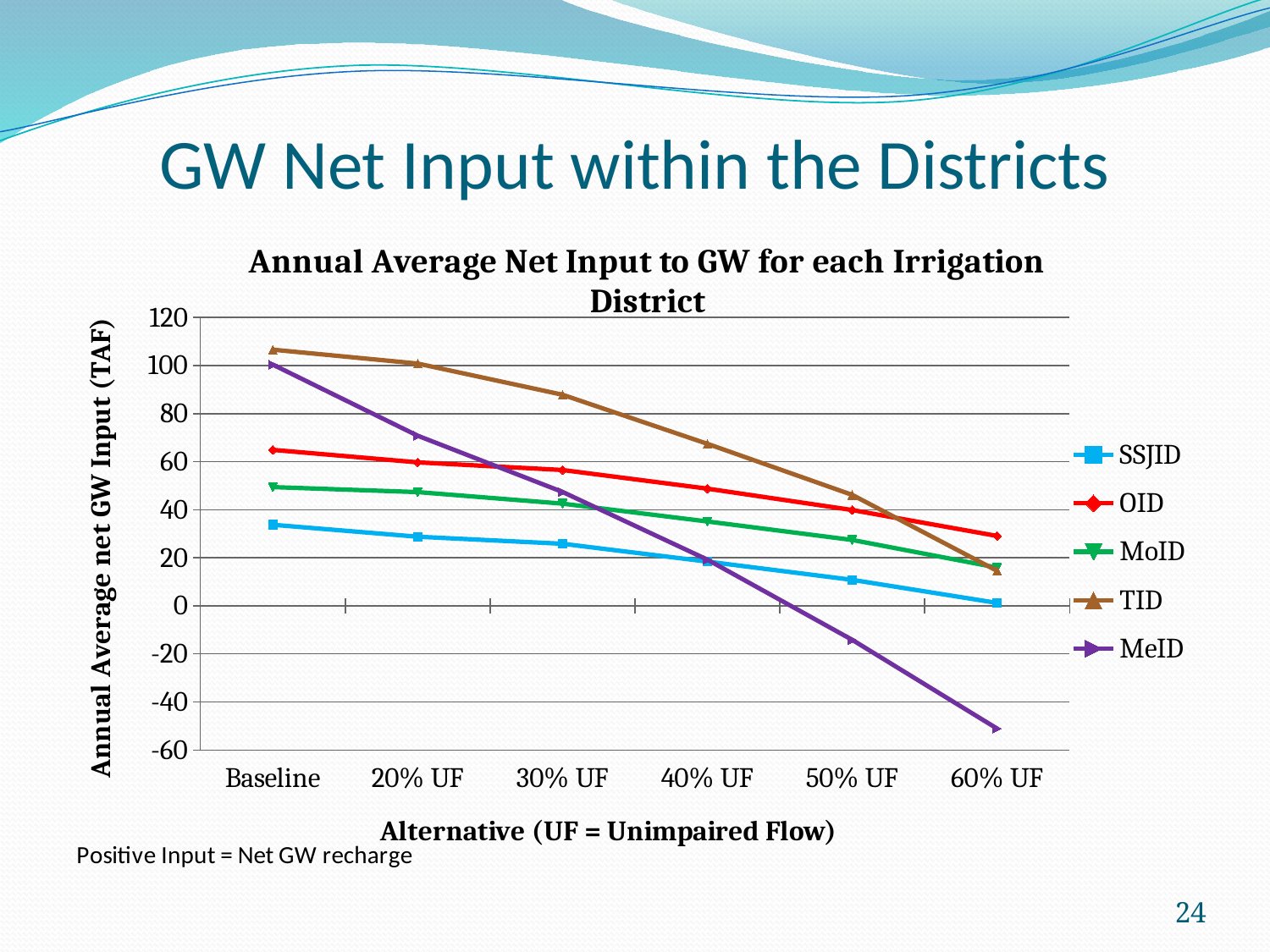
At Baseline, which is larger: the value for OID or the value for MoID? OID How many alternatives are shown along the x axis? 6 Is the value for MeID at 60% UF greater or less than -40? less What is the title of the y axis? Annual Average net GW Input (TAF) Does the MeID line rise or fall from Baseline to 60% UF? fall How many series does the legend list? 5 Is the value for TID at Baseline greater or less than 100? greater Is the value for SSJID at 50% UF greater or less than 20? less Which irrigation district has the lowest net GW input at 60% UF? MeID Which irrigation district has the highest net GW input at 30% UF? TID What kind of chart is shown on the slide? line chart Which irrigation district has the lowest net GW input at Baseline? SSJID